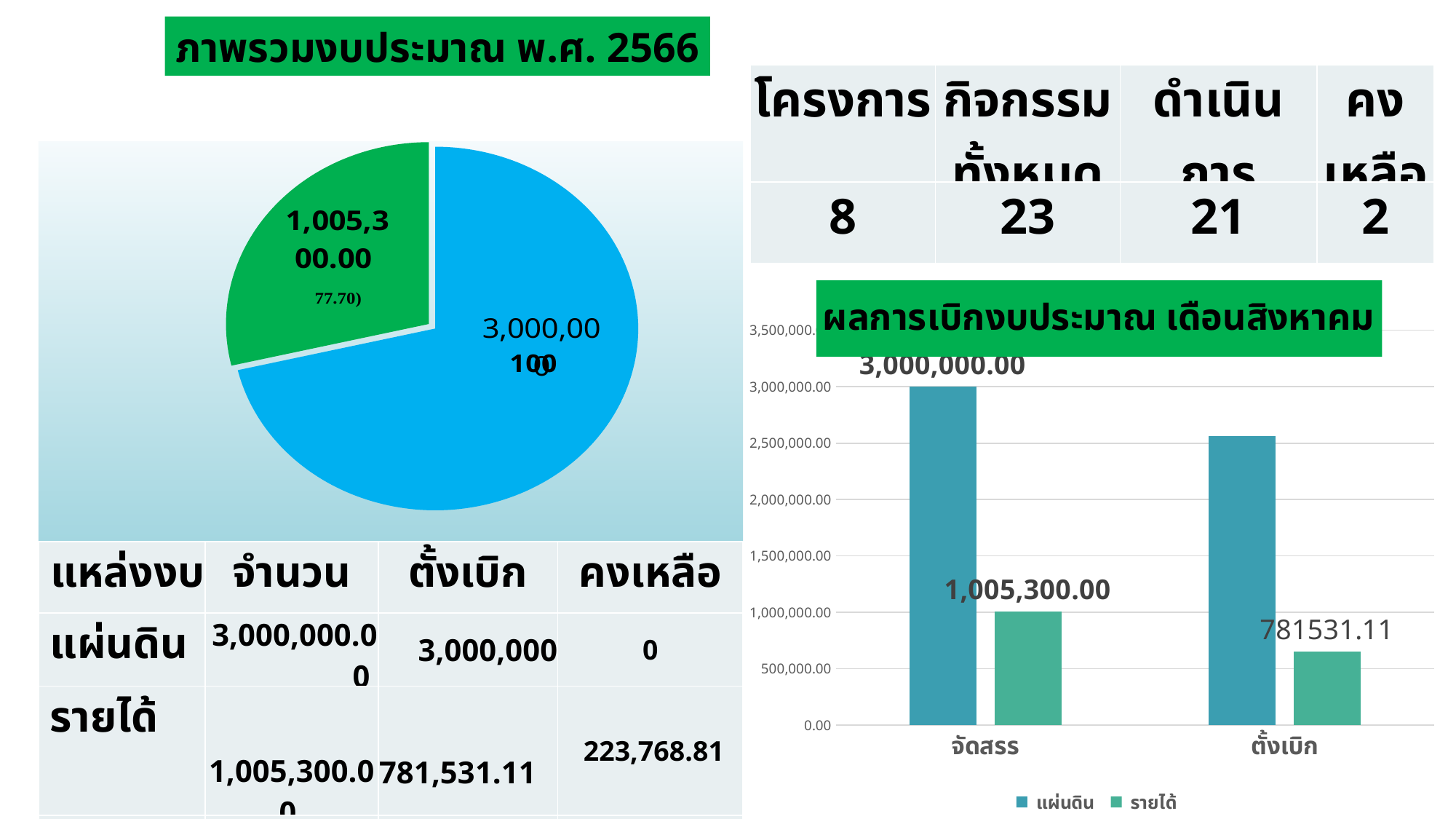
What kind of chart is shown on the left of the slide under the title ภาพรวมงบประมาณ พ.ศ. 2566? pie chart In the bar chart on the right, does the value for รายได้ rise or fall from จัดสรร to ตั้งเบิก? fall In the bar chart on the right, which series has the larger value in the จัดสรร category, แผ่นดิน or รายได้? แผ่นดิน In the pie chart on the left, how many slices are there? 2 In the pie chart on the left, what value is printed on the green slice? 1,005,300.00 In the bar chart on the right, what is the value for รายได้ in the จัดสรร category? 1,005,300.00 In the bar chart on the right, is the value for แผ่นดิน in the ตั้งเบิก category greater or less than 3,000,000.00? less In the bar chart on the right, how many categories are shown on the x axis? 2 In the bar chart on the right, what is the value for รายได้ in the ตั้งเบิก category? 781531.11 In the bar chart on the right, how many series does the legend list? 2 In the bar chart on the right, what is the value for แผ่นดิน in the จัดสรร category? 3,000,000.00 What kind of chart is the chart titled ผลการเบิกงบประมาณ เดือนสิงหาคม on the right of the slide? bar chart